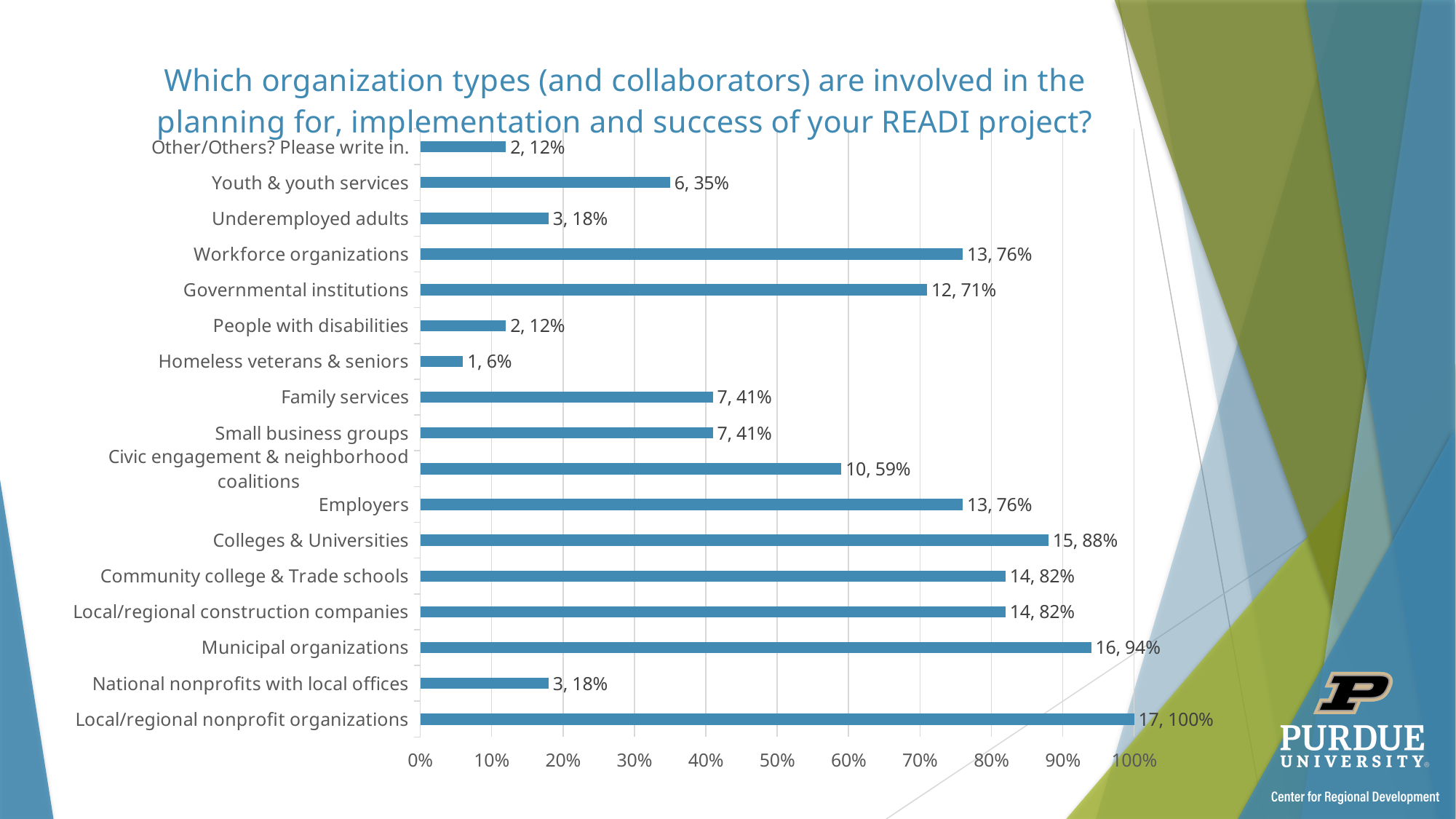
What is the highest tick label shown on the horizontal axis? 100% Is the value for Community college & Trade schools greater or less than 80%? greater Which organization type has the highest value? Local/regional nonprofit organizations What percentage is shown for Governmental institutions? 71% How many respondents are shown for Civic engagement & neighborhood coalitions? 10 What kind of chart is shown on the slide? Bar chart What percentage is shown for Youth & youth services? 35% What is the data label shown for Municipal organizations? 16, 94% How many organization types are listed on the chart? 17 Which organization type has the lowest value? Homeless veterans & seniors What is the difference in percentage points between Colleges & Universities and Employers? 12 Which has a larger value, Workforce organizations or Family services? Workforce organizations